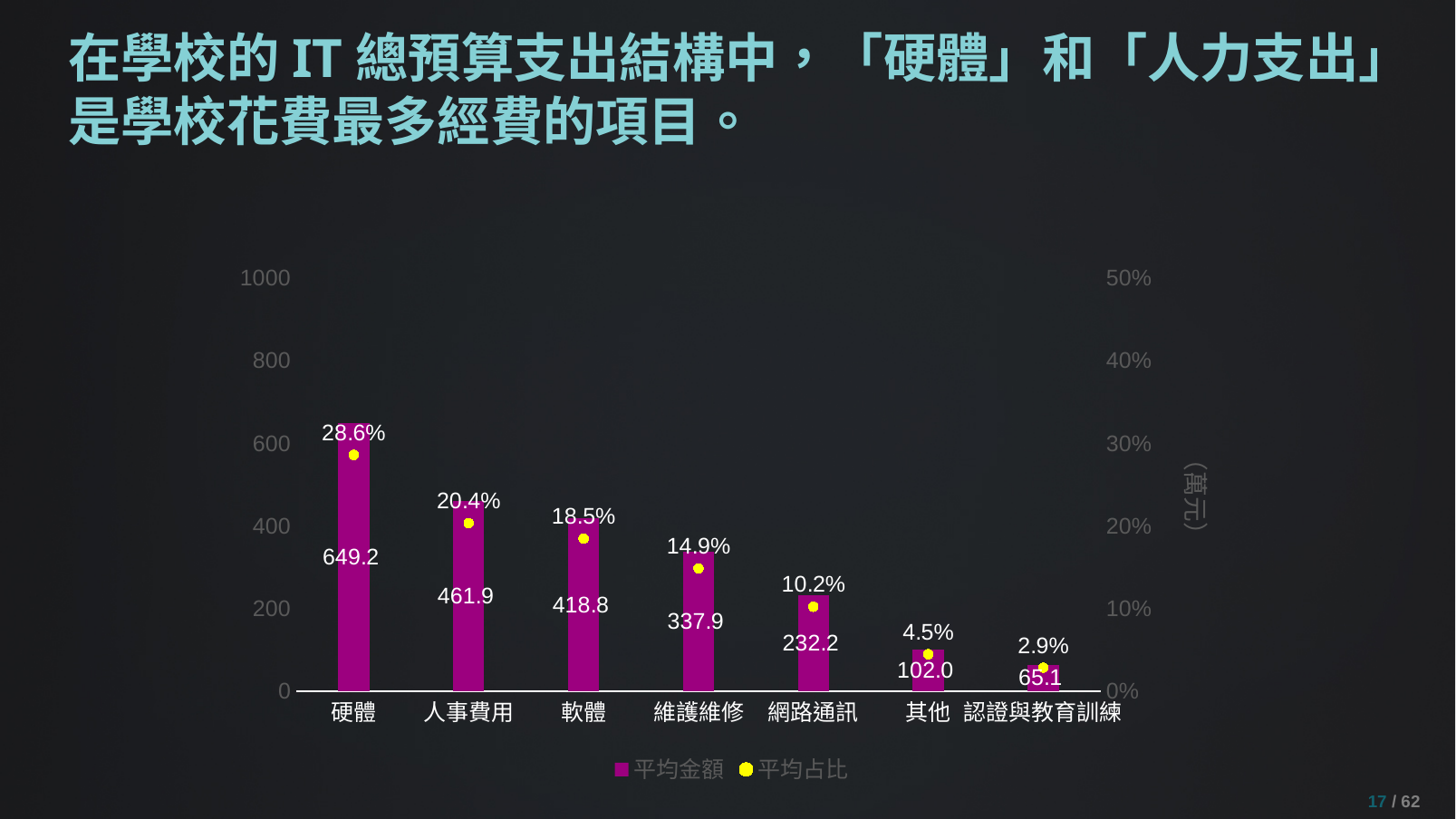
What is the 平均金額 value for 硬體? 649.2 What is the 平均占比 value for 人事費用? 20.4% What kind of chart is used for the 平均金額 series? bar chart How many categories are shown on the x axis? 7 What is the 平均金額 value for 網路通訊? 232.2 What is the difference in 平均金額 between 硬體 and 人事費用? 187.3 Which category has the lowest 平均占比? 認證與教育訓練 Do the 平均金額 values rise or fall from left to right along the x axis? fall Which has a larger 平均金額, 軟體 or 維護維修? 軟體 Which category has the highest 平均金額? 硬體 How many series does the legend list? 2 What is the 平均占比 value for 認證與教育訓練? 2.9%